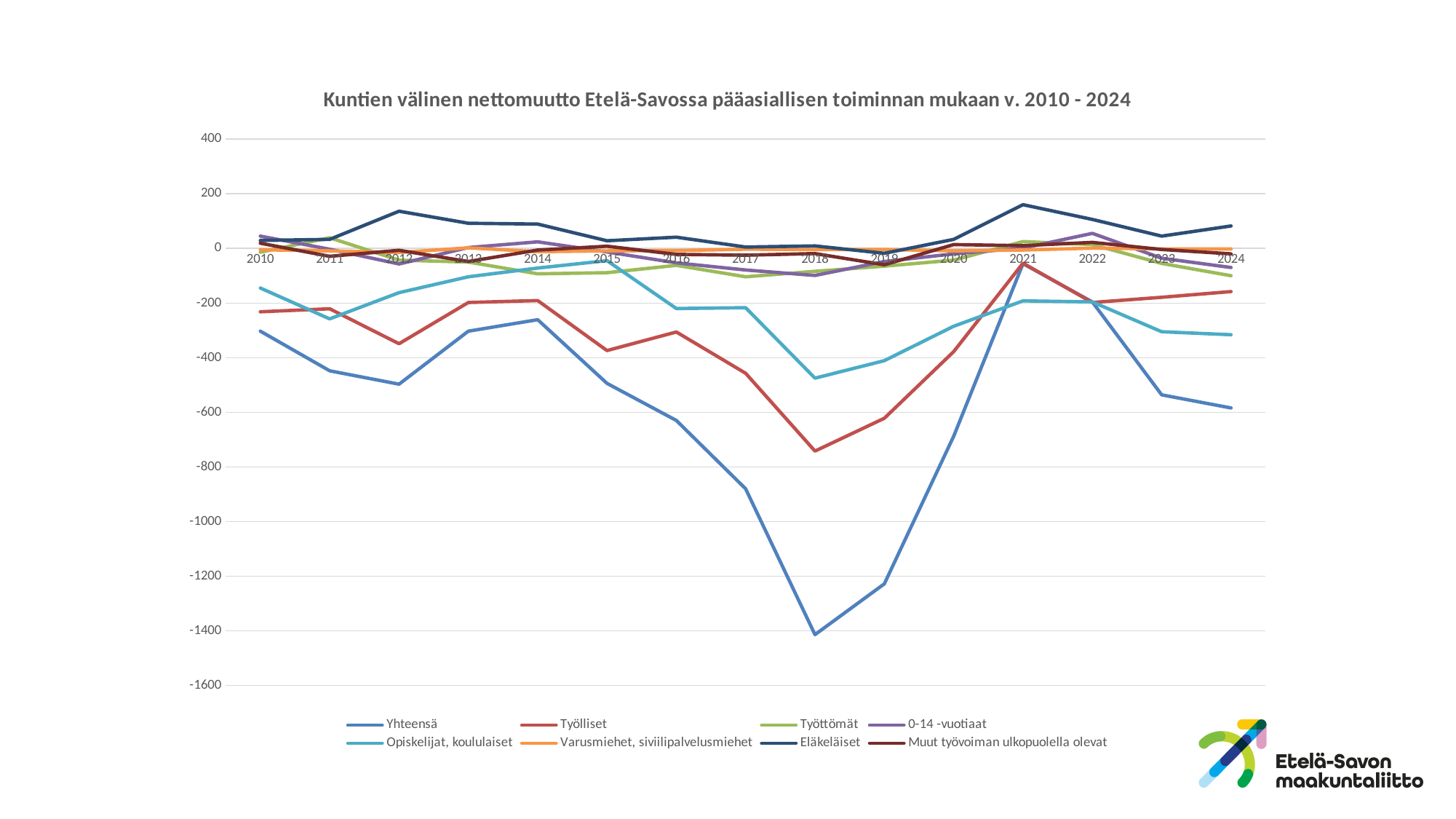
How many series does the legend list? 8 Does the Yhteensä series rise or fall from 2021 to 2024? Fall In which year does the Työlliset series reach its lowest value? 2018 In which year does the Yhteensä series reach its lowest value? 2018 How many years are plotted along the x axis? 15 In which year does the Eläkeläiset series reach its highest value? 2021 Is the value for Eläkeläiset in 2021 greater or less than 100? greater Is the value for Opiskelijat, koululaiset in 2018 greater or less than -400? less In which year does the Yhteensä series reach its highest value? 2021 Is the value for Yhteensä in 2018 greater or less than -1200? less What kind of chart is shown on the slide? Line chart In 2018, which is larger: the value for Työlliset or the value for Opiskelijat, koululaiset? Opiskelijat, koululaiset